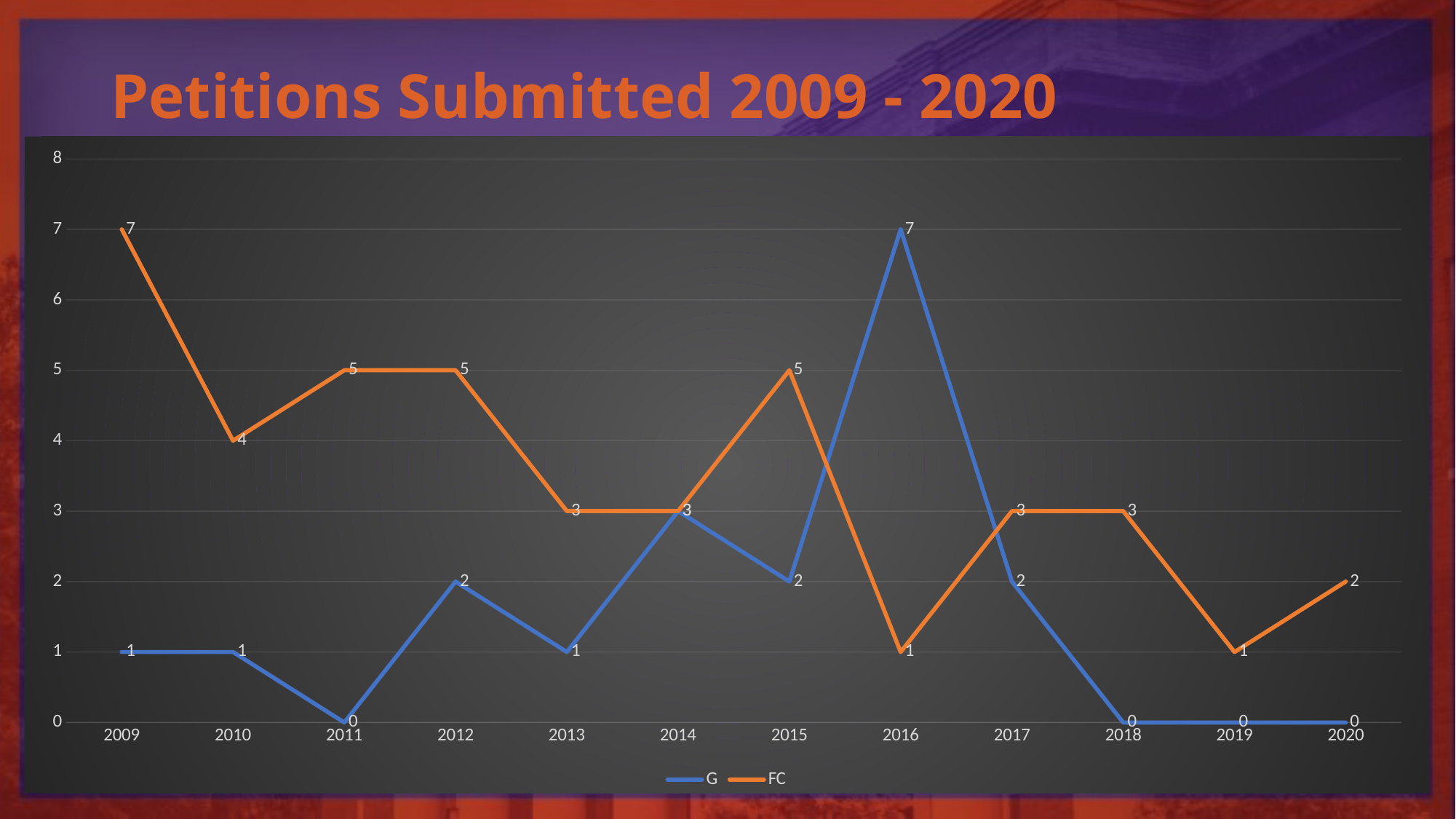
In 2017, which series has the larger value, G or FC? FC What is the title of the chart? Petitions Submitted 2009 - 2020 What is the value for FC in 2015? 5 In which year does the G series reach its highest value? 2016 What is the value for G in 2014? 3 What kind of chart is shown on the slide? Line chart What is the value for FC in 2009? 7 In which year does the FC series reach its lowest value? 2016 and 2019 What is the difference between FC and G in 2009? 6 How many years are shown on the x axis? 12 What is the value for G in 2016? 7 How many series does the legend list? 2